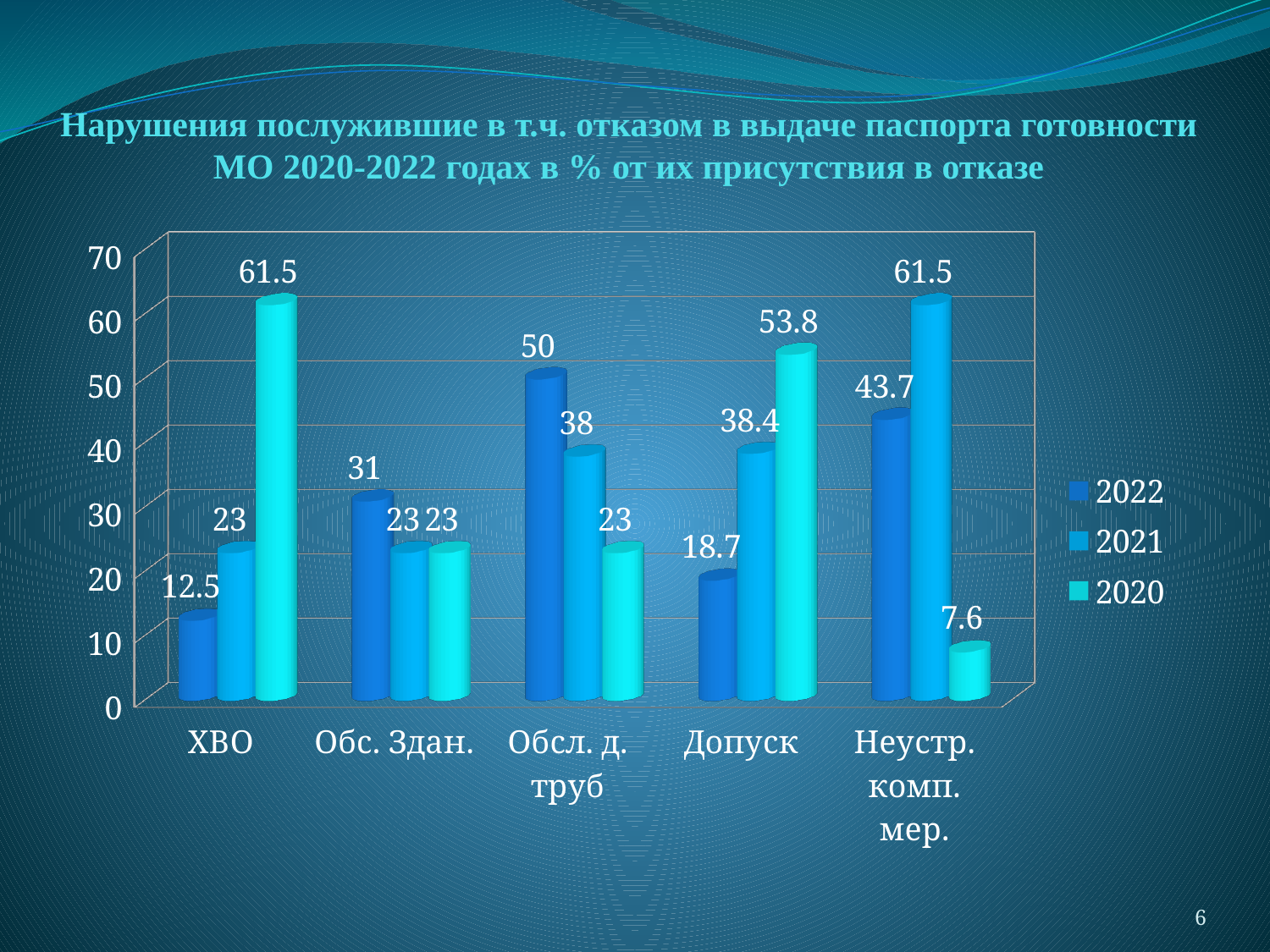
Which category has the highest value in the 2022 series? Обсл. д. труб What kind of chart is shown on the slide? Bar chart What is the value for Обсл. д. труб in the 2022 series? 50 Which is larger for Допуск: the 2021 value or the 2022 value? 2021 How many series does the legend list? 3 What is the value for ХВО in the 2020 series? 61.5 Which category has the lowest value in the 2020 series? Неустр. комп. мер. How many categories are shown on the x axis? 5 What is the difference between the 2020 and 2022 values for ХВО? 49 What is the value for Неустр. комп. мер. in the 2020 series? 7.6 What is the value for Допуск in the 2021 series? 38.4 Which series does the legend list first? 2022